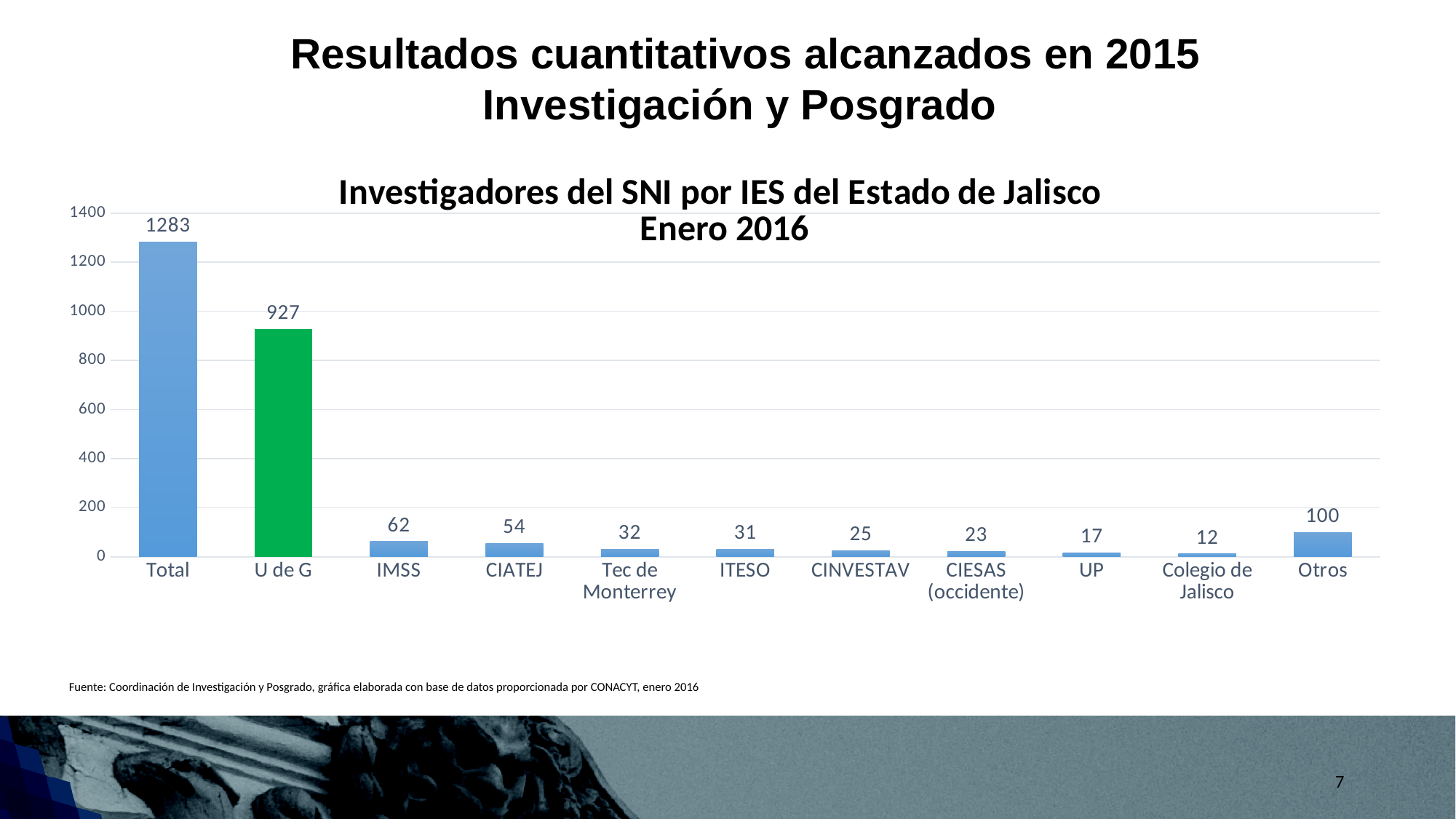
Which category has the lowest value? Colegio de Jalisco What is the title of the chart? Investigadores del SNI por IES del Estado de Jalisco Enero 2016 How many categories are shown on the x axis? 11 What is the value for IMSS? 62 What is the difference between the Total and U de G values? 356 Which is larger, the value for ITESO or the value for CINVESTAV? ITESO What is the difference between the values for IMSS and CIATEJ? 8 What kind of chart is shown on the slide? Bar chart What is the value for Otros? 100 What is the value for Tec de Monterrey? 32 Excluding the Total bar, which institution has the highest value? U de G What is the value for U de G? 927